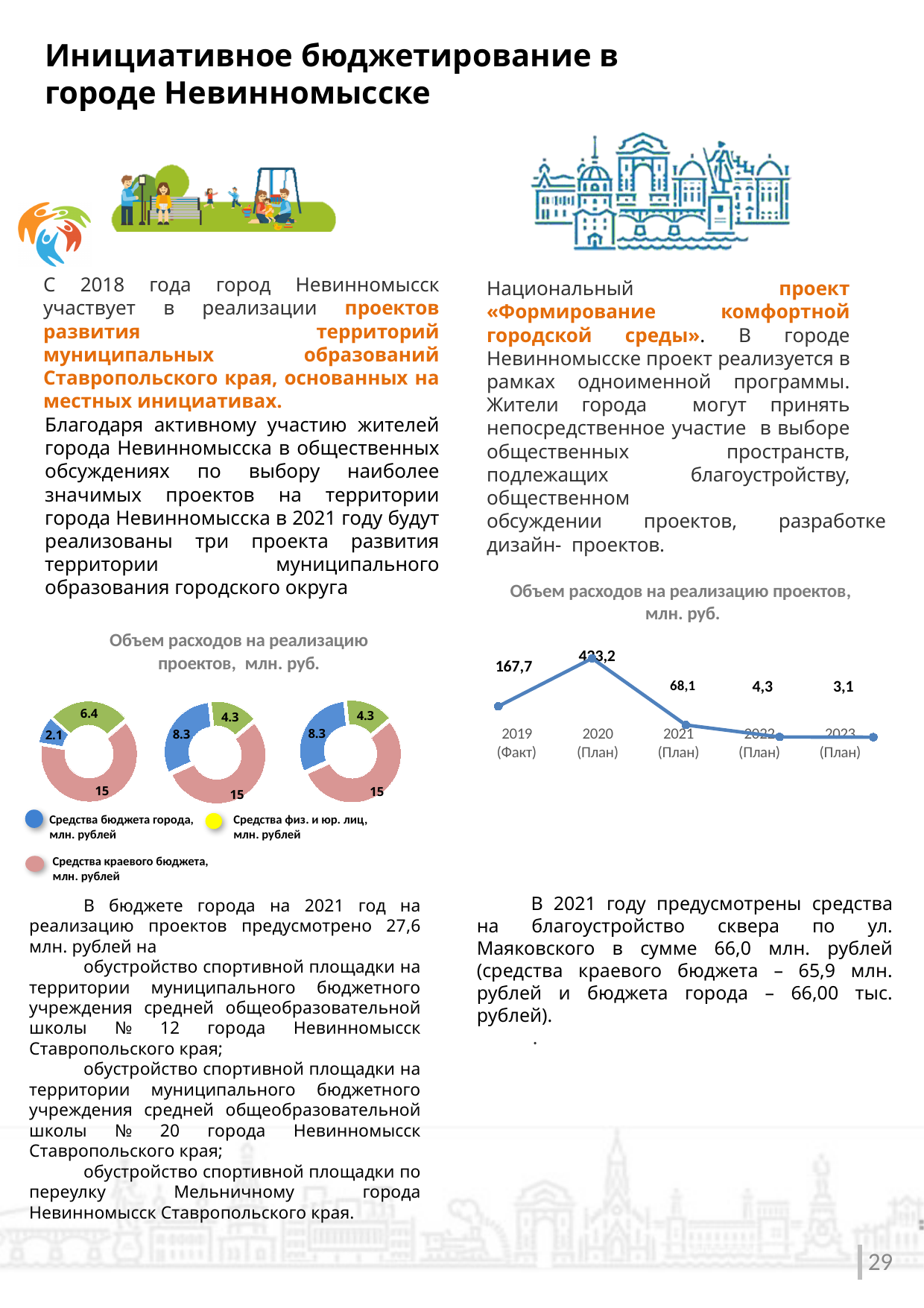
In the line chart on the right, which year has the lowest value? 2023 (План) In the middle donut chart on the left side of the slide, what is the value of the pink segment (Средства краевого бюджета)? 15 In the line chart on the right, is the value for 2021 (План) larger or smaller than the value for 2019 (Факт)? smaller In the leftmost donut chart on the left side of the slide, what is the value of the blue segment (Средства бюджета города)? 2.1 In the line chart on the right, what is the difference between the values for 2022 (План) and 2023 (План)? 1,2 In the line chart on the right, what is the value for 2019 (Факт)? 167,7 In the line chart on the right, how many data points are plotted? 5 In the line chart on the right, what is the value for 2023 (План)? 3,1 In the line chart on the right, what is the value for 2021 (План)? 68,1 In the line chart on the right, do the values rise or fall from 2020 to 2023? fall In the line chart on the right, which year has the highest value? 2020 (План) What kind of chart is the chart on the right titled 'Объем расходов на реализацию проектов, млн. руб.' with years on the x axis? line chart